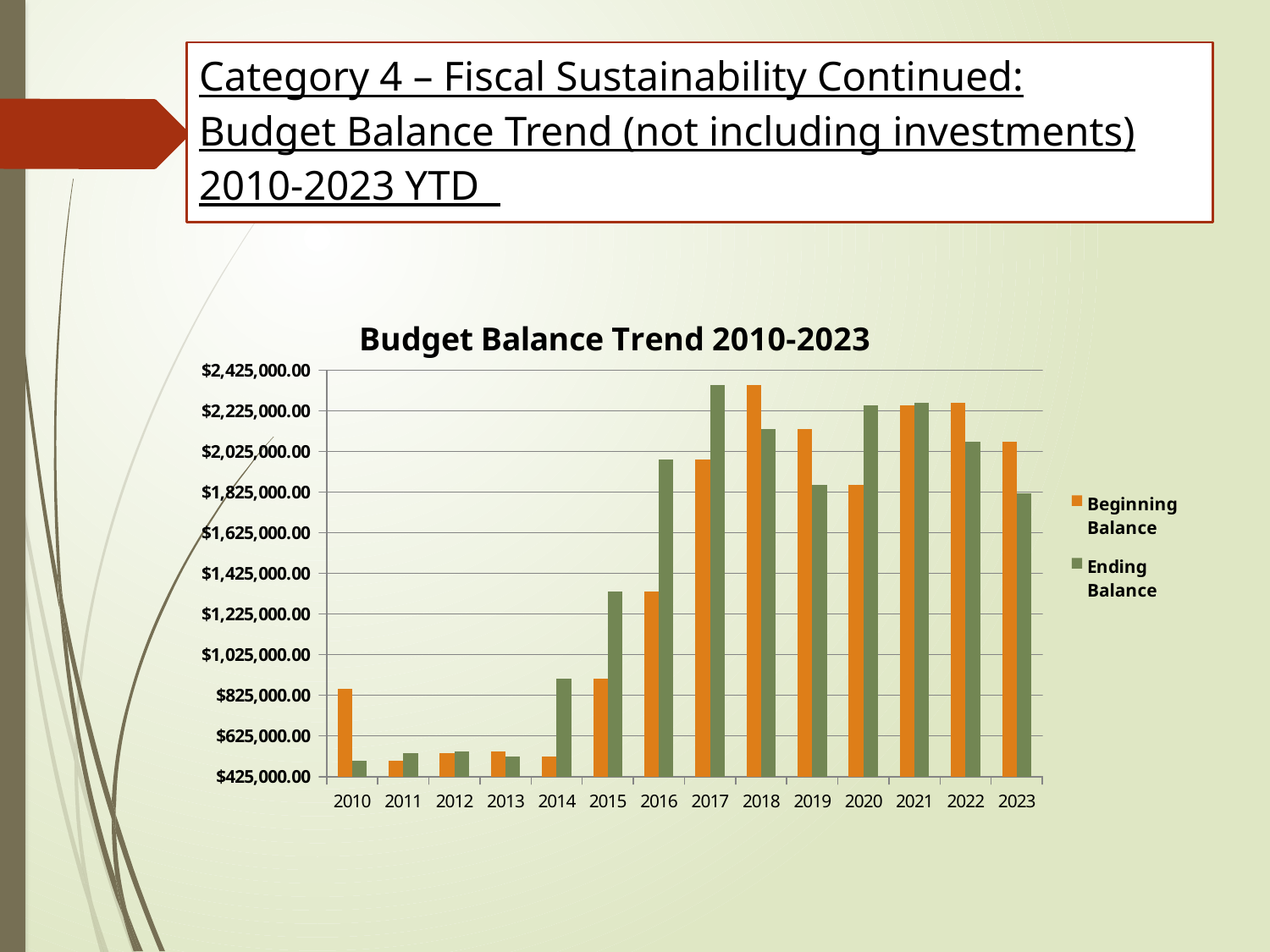
How many series does the legend list in the Budget Balance Trend 2010-2023 chart? 2 Which year has the highest Ending Balance? 2017 In 2016, which is larger, the Beginning Balance or the Ending Balance? Ending Balance Is the Beginning Balance for 2010 greater or less than $625,000.00? greater Which year has the highest Beginning Balance? 2018 In 2010, which is larger, the Beginning Balance or the Ending Balance? Beginning Balance Is the Ending Balance for 2023 greater or less than $2,025,000.00? less Does the Ending Balance rise or fall from 2013 to 2017? Rise How many years are shown on the x axis of the Budget Balance Trend 2010-2023 chart? 14 What kind of chart is shown on the slide? Bar chart Is the Ending Balance for 2016 greater or less than $1,825,000.00? greater